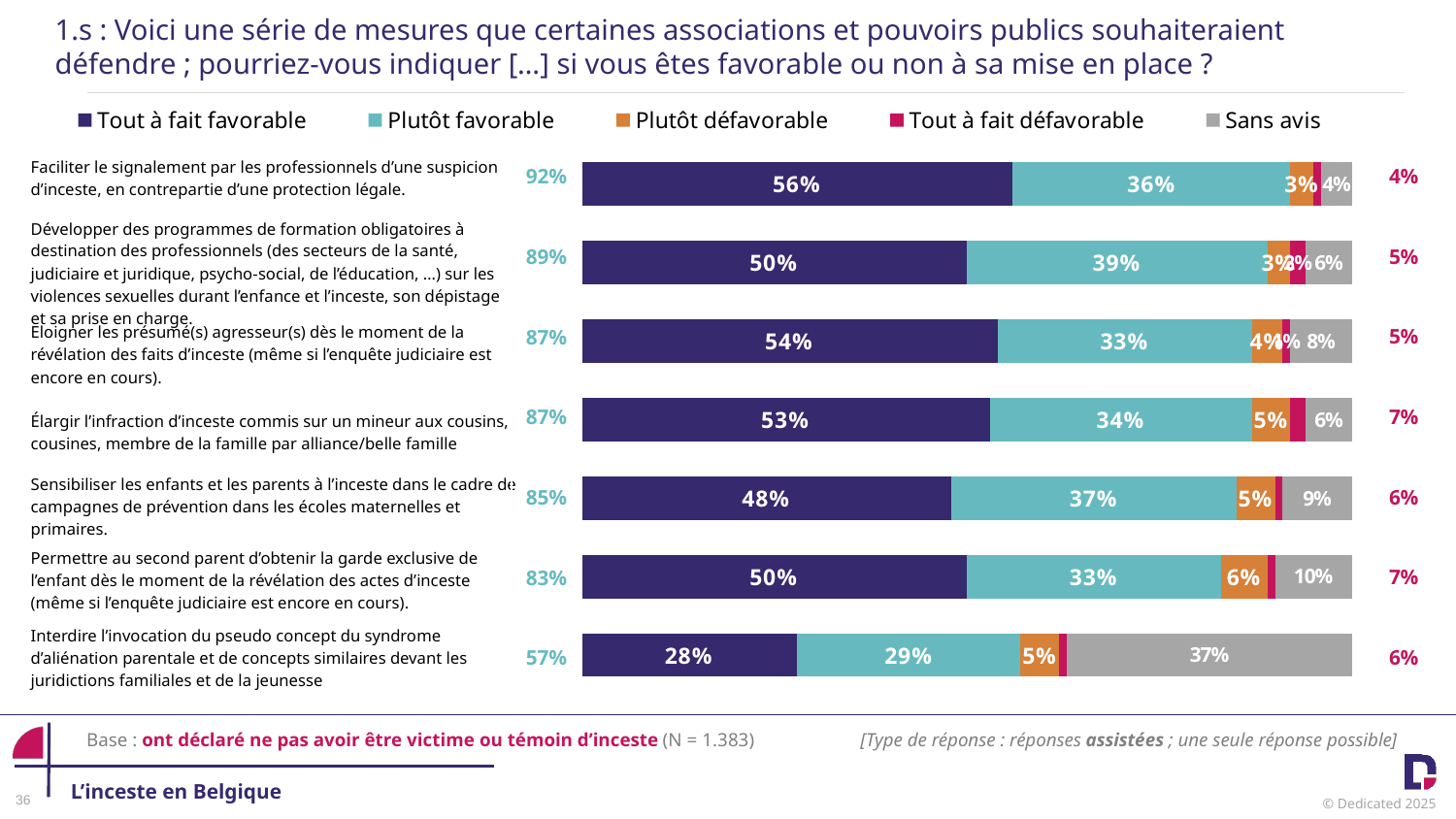
What is the "Sans avis" value for the measure "Permettre au second parent d'obtenir la garde exclusive de l'enfant"? 10% What is the "Plutôt favorable" value for the measure "Développer des programmes de formation obligatoires"? 39% Which measure has the lowest "Tout à fait favorable" percentage? Interdire l'invocation du pseudo concept du syndrome d'aliénation parentale (28%) Which has a higher "Plutôt favorable" value: "Sensibiliser les enfants et les parents à l'inceste" or "Éloigner les présumé(s) agresseur(s)"? Sensibiliser les enfants et les parents à l'inceste (37%) Which measure has the largest "Sans avis" share? Interdire l'invocation du pseudo concept du syndrome d'aliénation parentale (37%) How many response categories does the legend list? 5 How many measures (bars) are shown in the chart? 7 Which measure has the highest "Tout à fait favorable" percentage? Faciliter le signalement par les professionnels d'une suspicion d'inceste (56%) What is the "Plutôt défavorable" value for the measure "Permettre au second parent d'obtenir la garde exclusive de l'enfant"? 6% What is the difference in "Tout à fait favorable" between "Faciliter le signalement par les professionnels" and "Interdire l'invocation du pseudo concept du syndrome d'aliénation parentale"? 28 percentage points What percentage of respondents are "Tout à fait favorable" to the measure "Faciliter le signalement par les professionnels d'une suspicion d'inceste"? 56% What is the "Sans avis" share for the measure "Interdire l'invocation du pseudo concept du syndrome d'aliénation parentale"? 37%